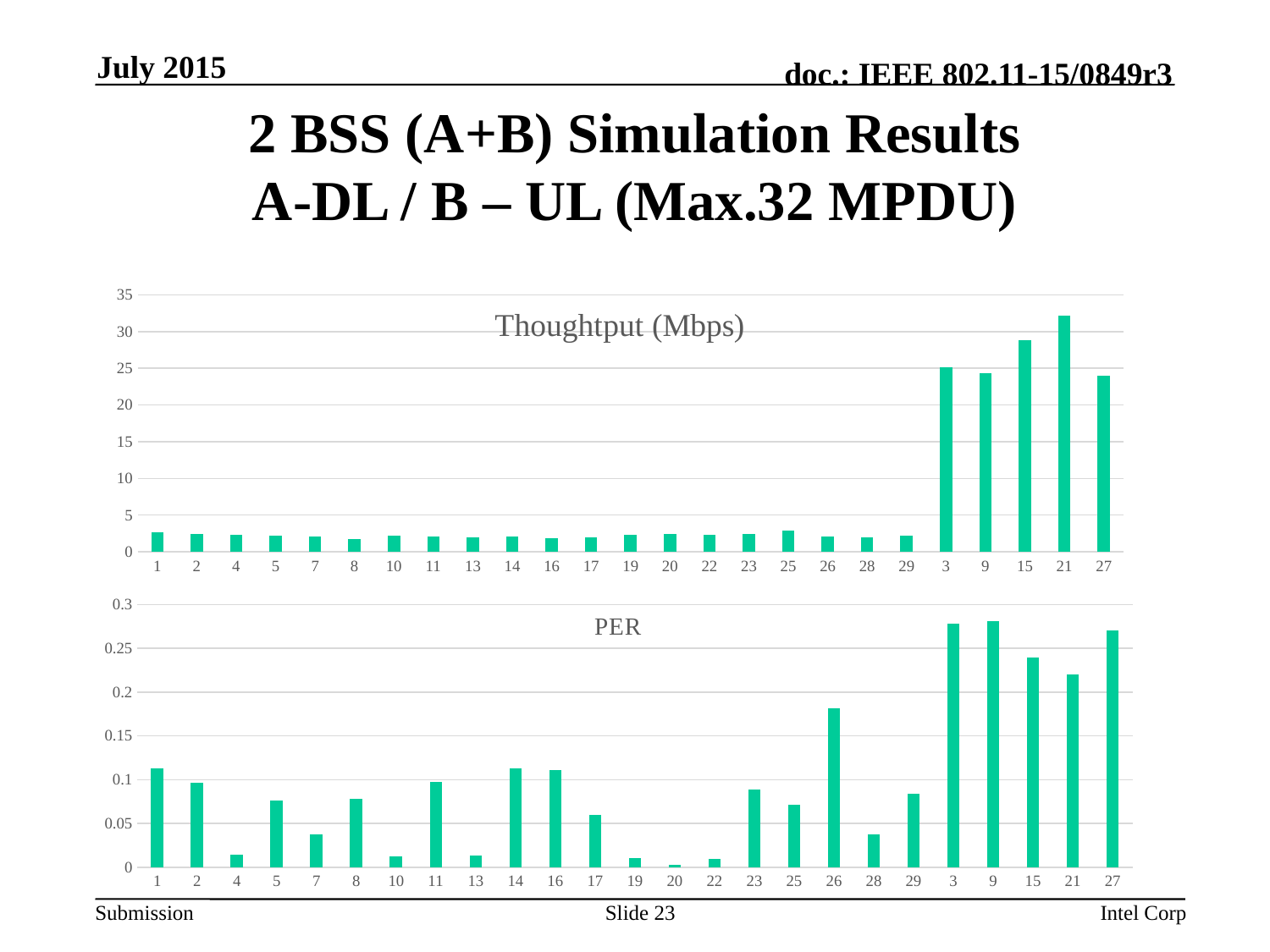
How many categories are shown on the x axis of the PER chart? 25 In the Thoughtput (Mbps) chart, which is larger, the value for category 21 or category 27? 21 In the Thoughtput (Mbps) chart, is the value for category 21 greater or less than 30? greater In the Thoughtput (Mbps) chart, is the value for category 1 greater or less than 5? less In the PER chart, is the value for category 26 greater or less than 0.15? greater What kind of chart is the Thoughtput (Mbps) chart? bar chart What is the title of the top chart on the slide? Thoughtput (Mbps) In the Thoughtput (Mbps) chart, which category has the highest value? 21 In the PER chart, which category has the lowest value? 20 In the PER chart, which is larger, the value for category 26 or category 25? 26